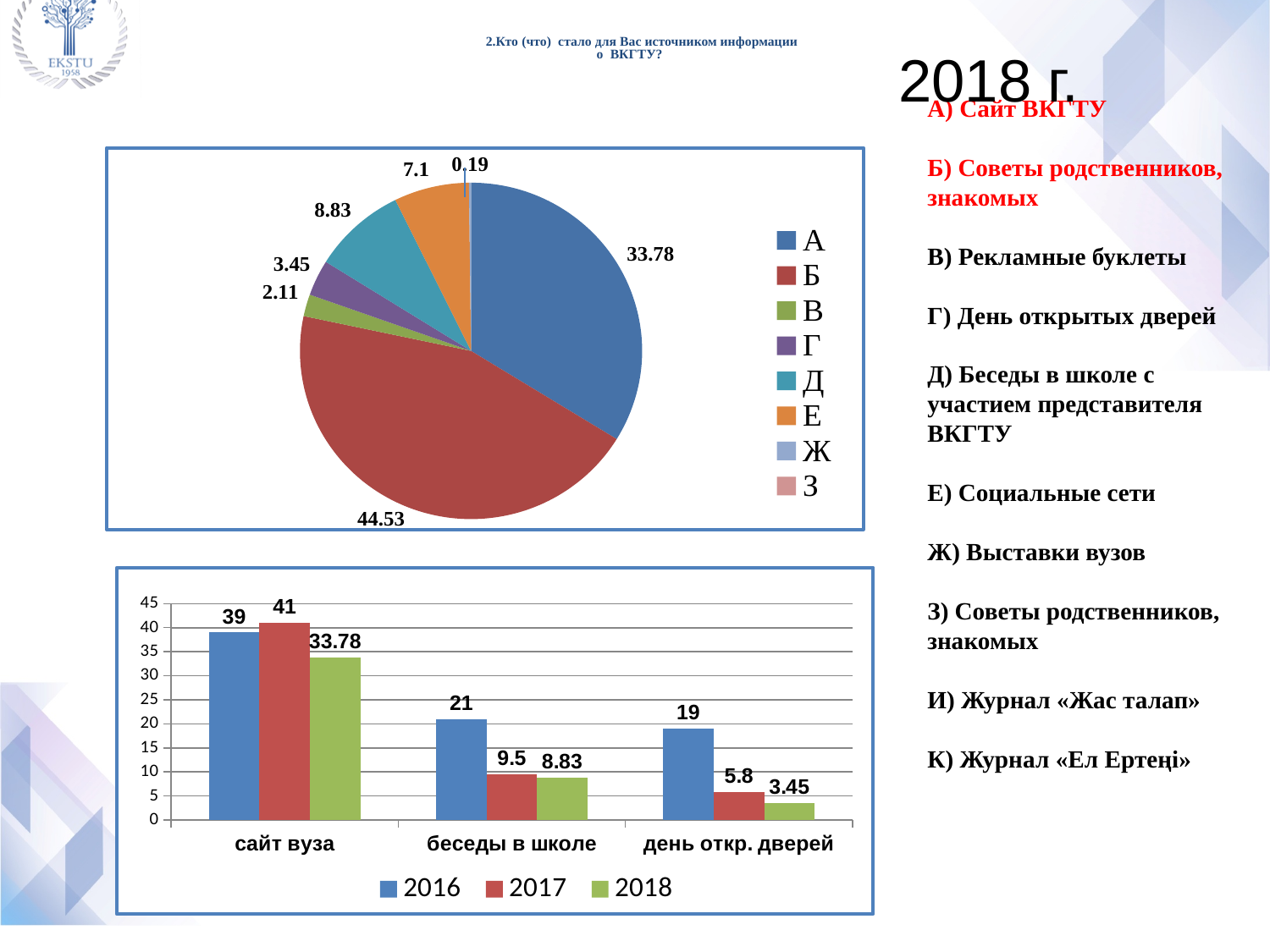
What kind of chart is the chart at the bottom of the slide? bar chart In the pie chart at the top of the slide, what is the value for slice Б? 44.53 In the bar chart at the bottom of the slide, what is the difference between the 2016 and 2018 values for 'беседы в школе'? 12.17 In the bar chart at the bottom of the slide, how many categories are shown on the x axis? 3 In the bar chart at the bottom of the slide, how many series does the legend list? 3 In the pie chart at the top of the slide, how many entries does the legend list? 8 In the bar chart at the bottom of the slide, which is larger for 'беседы в школе': the 2016 value or the 2017 value? 2016 In the bar chart at the bottom of the slide, what is the value for 2017 in the category 'сайт вуза'? 41 In the pie chart at the top of the slide, what is the difference between the values for А and Е? 26.68 In the pie chart at the top of the slide, which labelled slice is the largest? Б In the pie chart at the top of the slide, what is the value for slice Д? 8.83 In the bar chart at the bottom of the slide, what is the value for 2018 in the category 'день откр. дверей'? 3.45